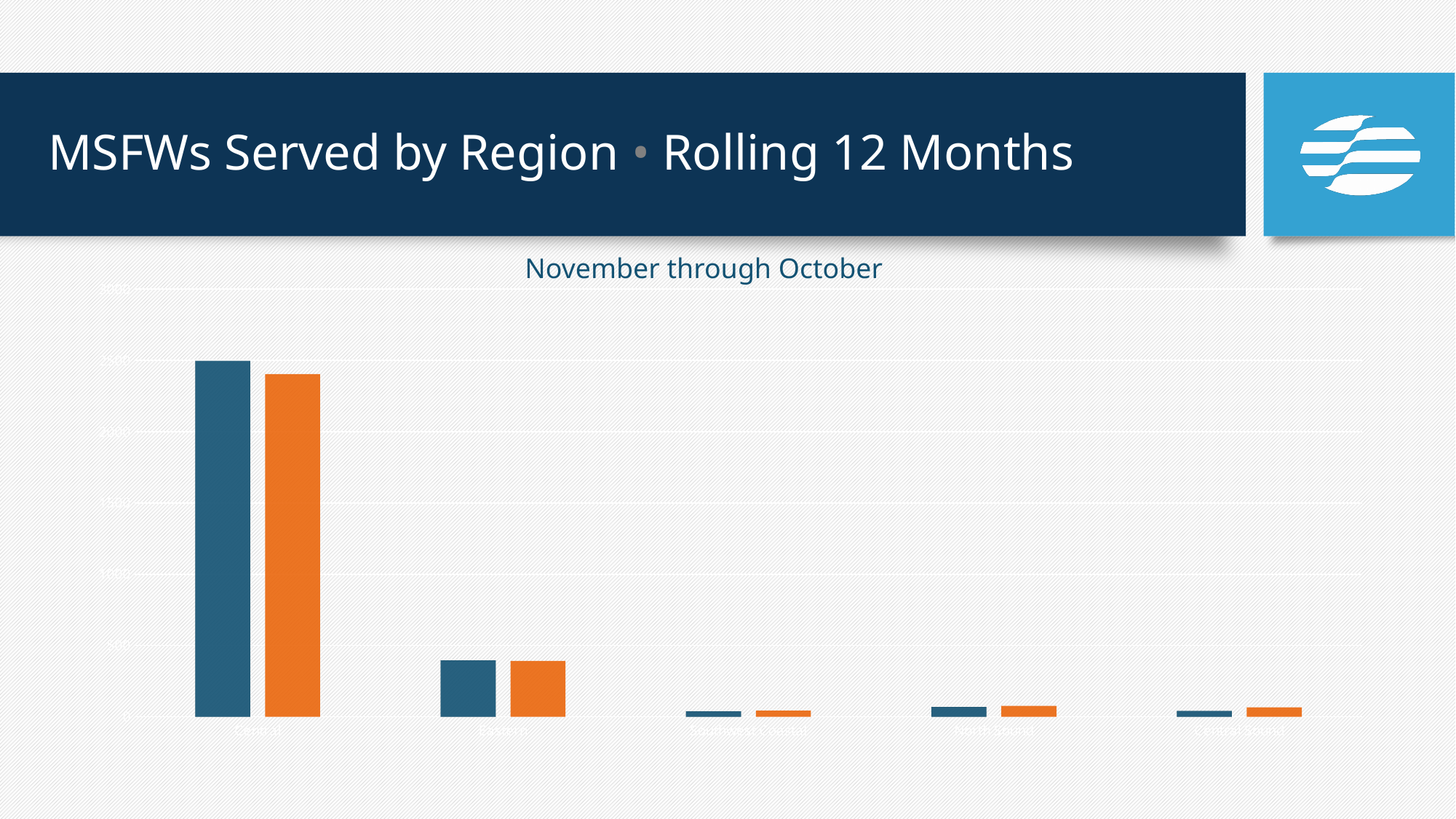
In the leftmost category group, which bar is taller, the blue one or the orange one? the blue one Are the bars in the first (leftmost) group taller or shorter than the bars in the second group? taller Which category group, by position from the left, has the tallest bars? the first (leftmost) group Which category group, by position from the left, has the second tallest bars? the second group How many bars are plotted for each category group? 2 How many category groups of bars does the chart show? 5 What kind of chart is shown on the slide? bar chart Which category group, by position from the left, has the shortest bars? the third group What is the title printed above the chart? November through October What two colours are used for the bars in the chart? blue and orange